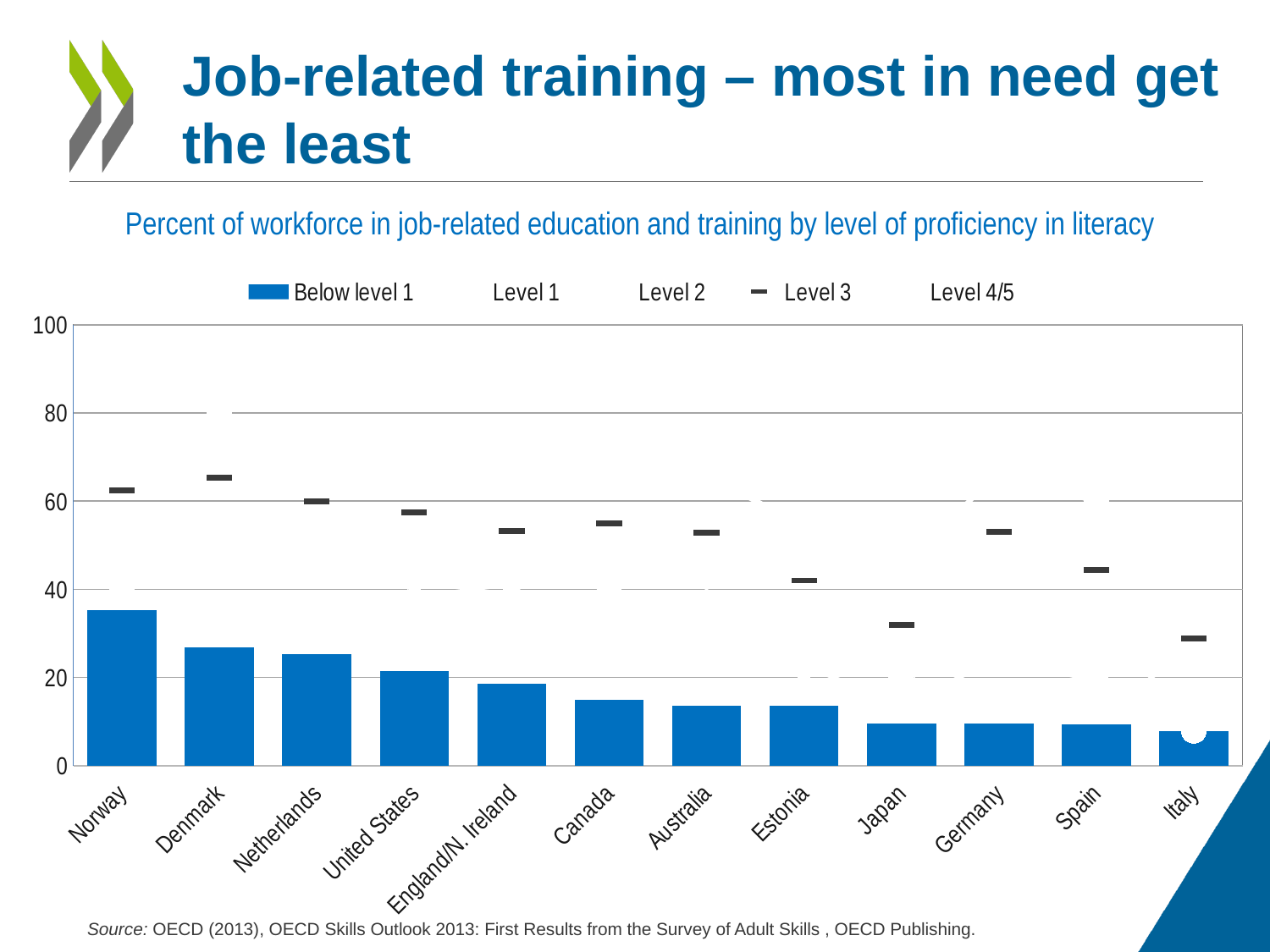
Is the 'Level 3' value for Spain greater or less than 40? greater Which country has the lowest 'Below level 1' bar? Italy Which country has the highest 'Below level 1' bar? Norway What kind of chart is shown on the slide? bar chart Do the 'Below level 1' bars rise or fall from left to right across the countries? fall Which country has the lowest 'Level 3' marker? Italy Is the 'Level 3' value for Japan greater or less than 40? less Which has the larger 'Below level 1' value, Denmark or Netherlands? Denmark Is the 'Below level 1' value for Norway greater or less than 40? less How many countries are shown along the x axis of the chart? 12 Which country has the highest 'Level 3' marker? Denmark How many series does the chart's legend list? 5